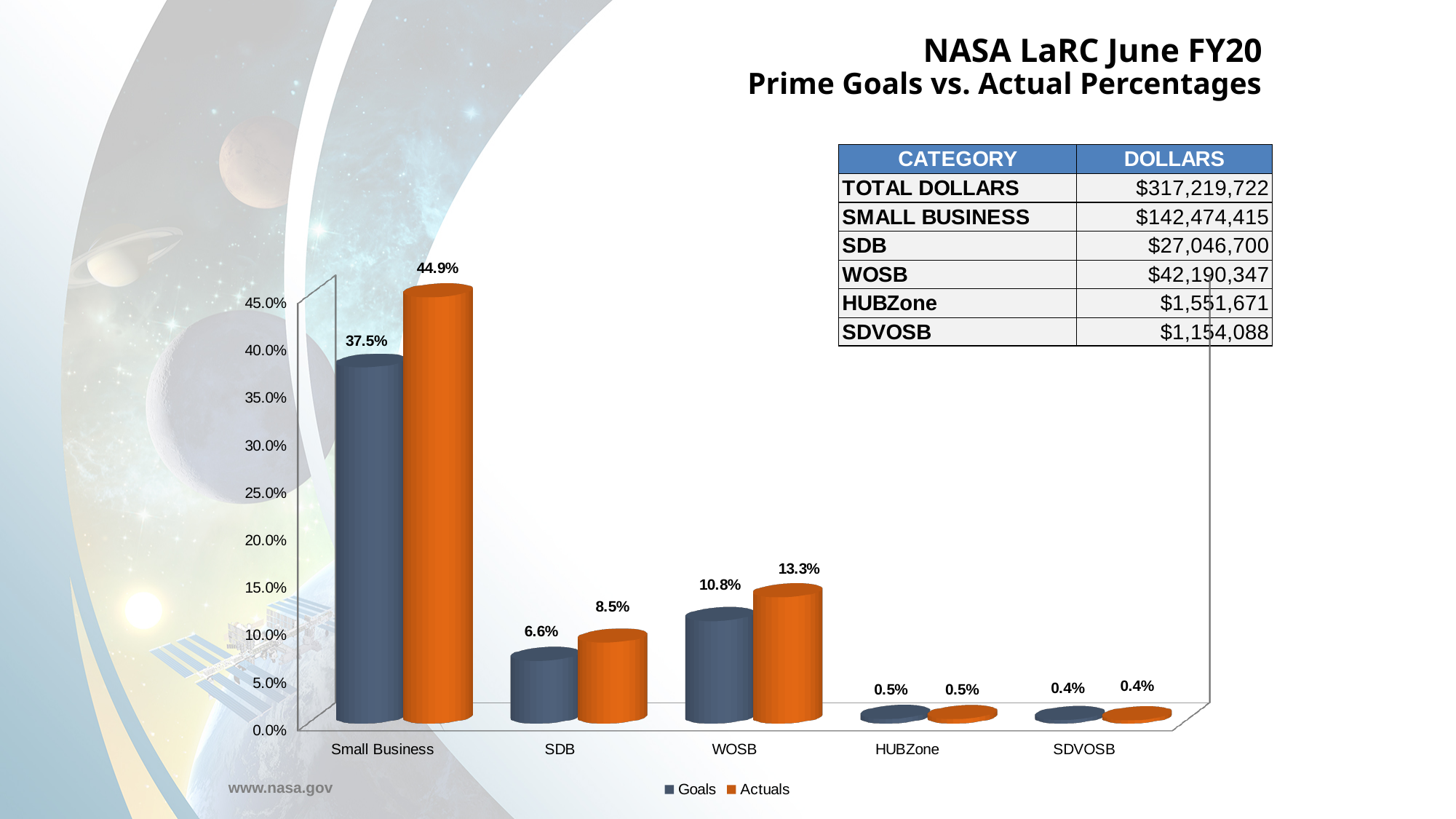
Which category has the highest Actuals value? Small Business What kind of chart is shown on the slide? Bar chart Which is larger for SDB, the Goals value or the Actuals value? Actuals Which category has the lowest Goals value? SDVOSB What is the Goals value for HUBZone? 0.5% How many categories are shown on the x axis? 5 What is the Goals value for WOSB? 10.8% What is the Actuals value for SDB? 8.5% How many series does the legend list? 2 What is the Actuals value for Small Business? 44.9% What is the difference between the Actuals and Goals values for WOSB? 2.5% What is the difference between the Actuals and Goals values for Small Business? 7.4%